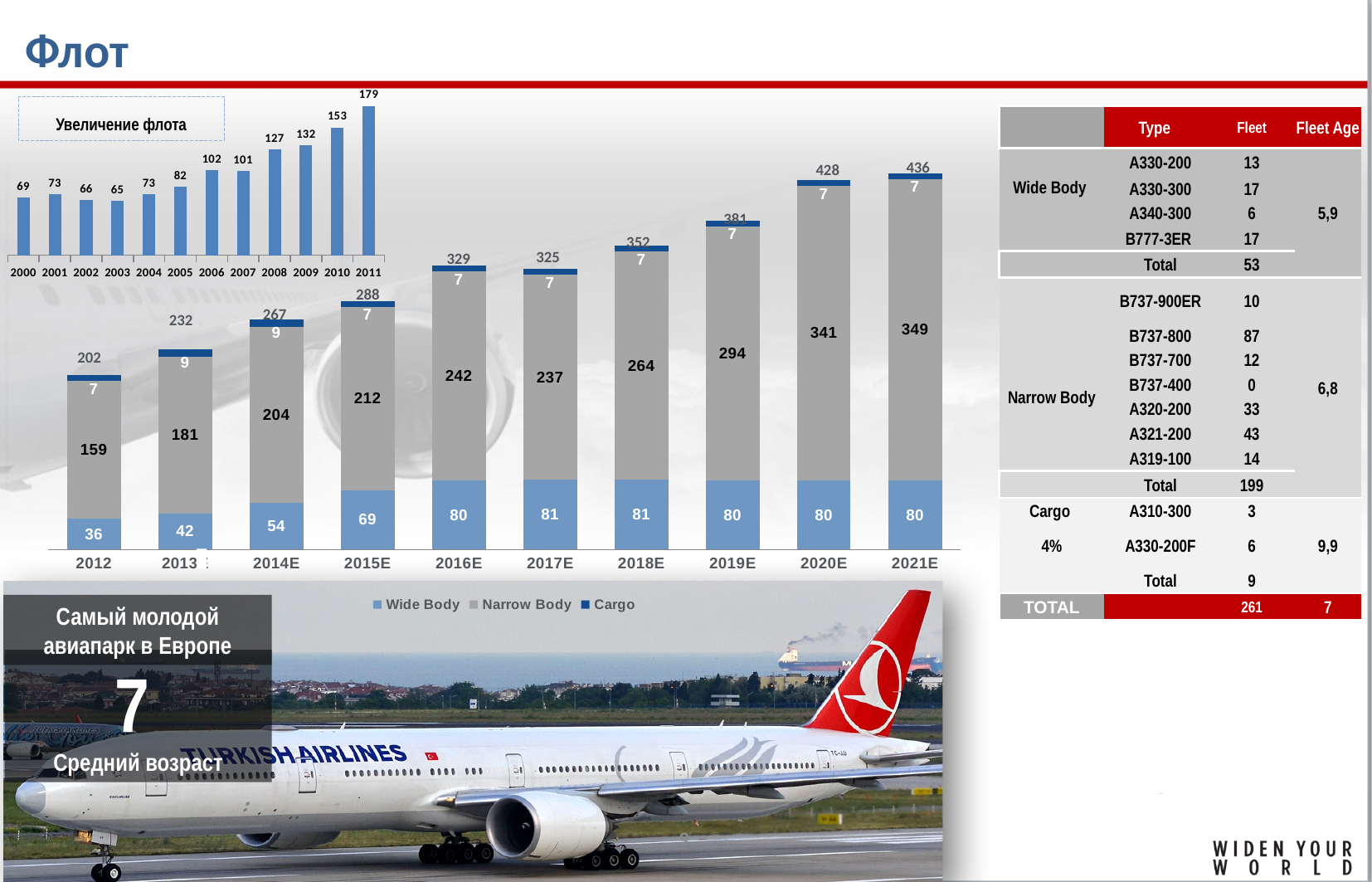
In the large stacked bar chart, what is the Narrow Body value for 2019E? 294 In the 'Увеличение флота' chart, how many years are shown on the x axis? 12 In the large stacked bar chart, what is the total of the stacked bar for 2021E? 436 In the large stacked bar chart, which year has the highest total? 2021E In the 'Увеличение флота' chart, what is the difference between the values for 2010 and 2009? 21 In the large stacked bar chart, what is the Wide Body value for 2014E? 54 What kind of chart is the large chart showing 2012 to 2021E? Stacked bar chart In the large stacked bar chart, what is the difference between the totals for 2020E and 2019E? 47 In the 'Увеличение флота' chart, which year has the lowest value? 2003 In the large stacked bar chart, which is larger, the Narrow Body value for 2016E or for 2017E? 2016E How many series does the legend of the large stacked bar chart list? 3 In the 'Увеличение флота' chart, what is the value for 2011? 179